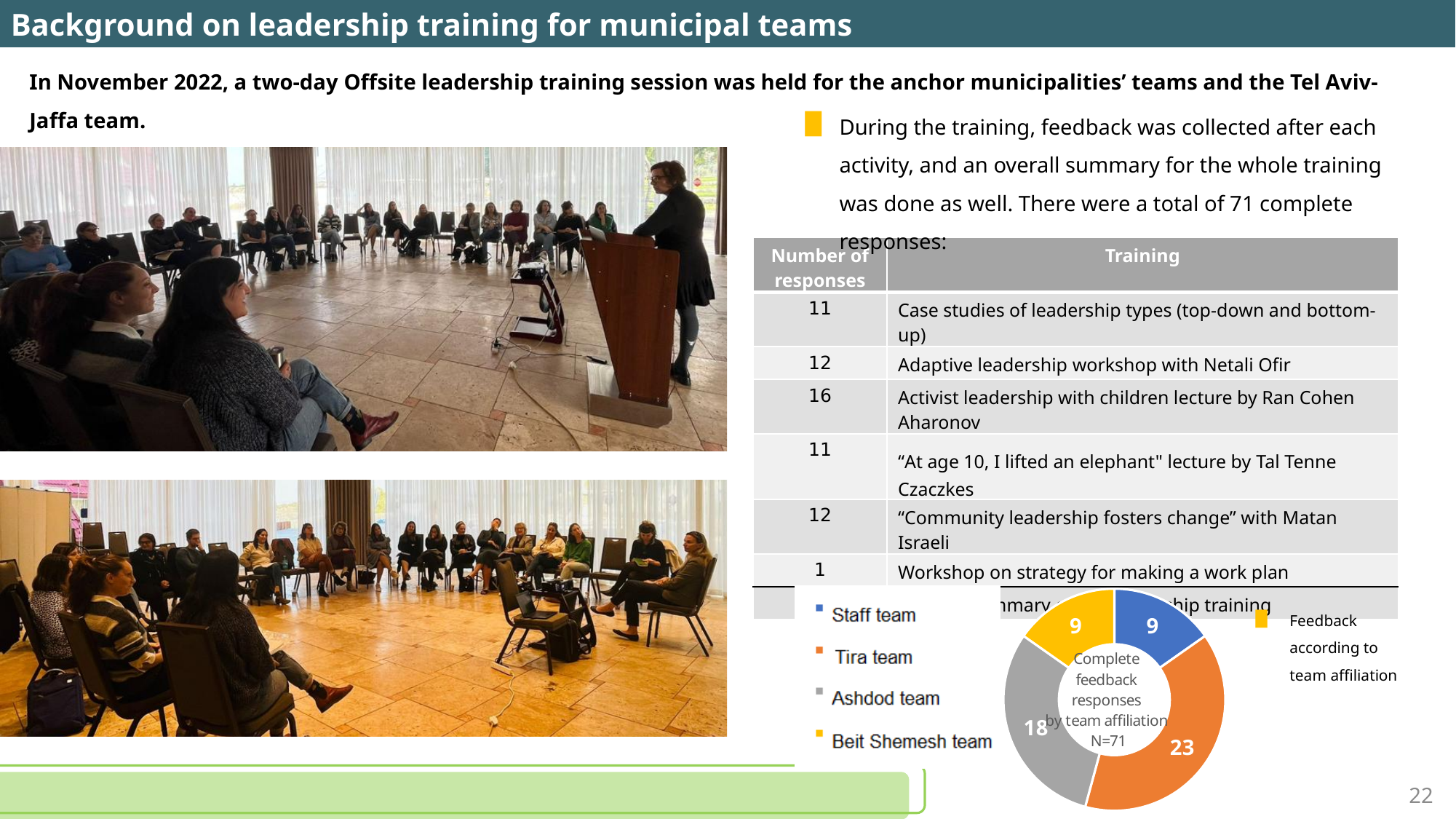
What kind of chart is used to show complete feedback responses by team affiliation? doughnut chart How many complete feedback responses came from the Tira team? 23 What colour represents the Tira team in the doughnut chart? orange How many complete feedback responses came from the Beit Shemesh team? 9 What is the difference between the Tira team's and the Staff team's complete feedback responses? 14 Which two teams share the smallest number of complete feedback responses in the doughnut chart? Staff team and Beit Shemesh team How many complete feedback responses came from the Staff team? 9 Which team has the largest number of complete feedback responses in the doughnut chart? Tira team Which has more complete feedback responses, the Ashdod team or the Beit Shemesh team? Ashdod team How many more complete feedback responses did the Tira team give than the Ashdod team? 5 How many teams are shown in the doughnut chart of complete feedback responses? 4 How many complete feedback responses came from the Ashdod team? 18